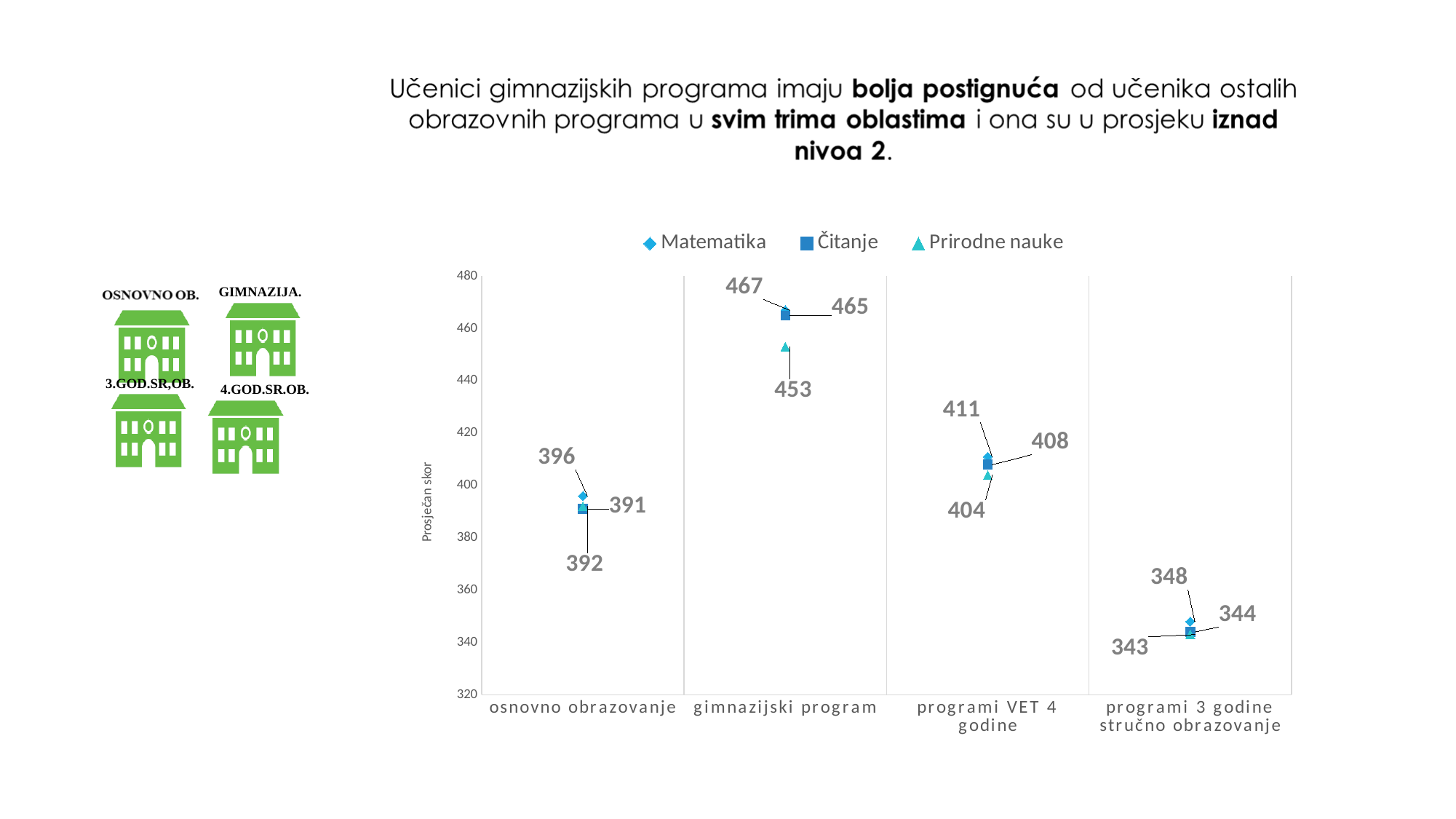
Which marker shape represents Prirodne nauke in the legend? triangle Which category has the lowest Prirodne nauke value? programi 3 godine stručno obrazovanje How many series does the legend list? 3 What is the label of the vertical axis? Prosječan skor What is the Matematika value for gimnazijski program? 467 Which category has the highest Matematika value? gimnazijski program What is the Prirodne nauke value for programi VET 4 godine? 404 What is the Čitanje value for programi 3 godine stručno obrazovanje? 344 How many categories are shown on the x axis? 4 Which is larger: the Čitanje value for programi VET 4 godine or for osnovno obrazovanje? programi VET 4 godine What is the difference between the Matematika values for gimnazijski program and osnovno obrazovanje? 71 What is the Čitanje value for osnovno obrazovanje? 391